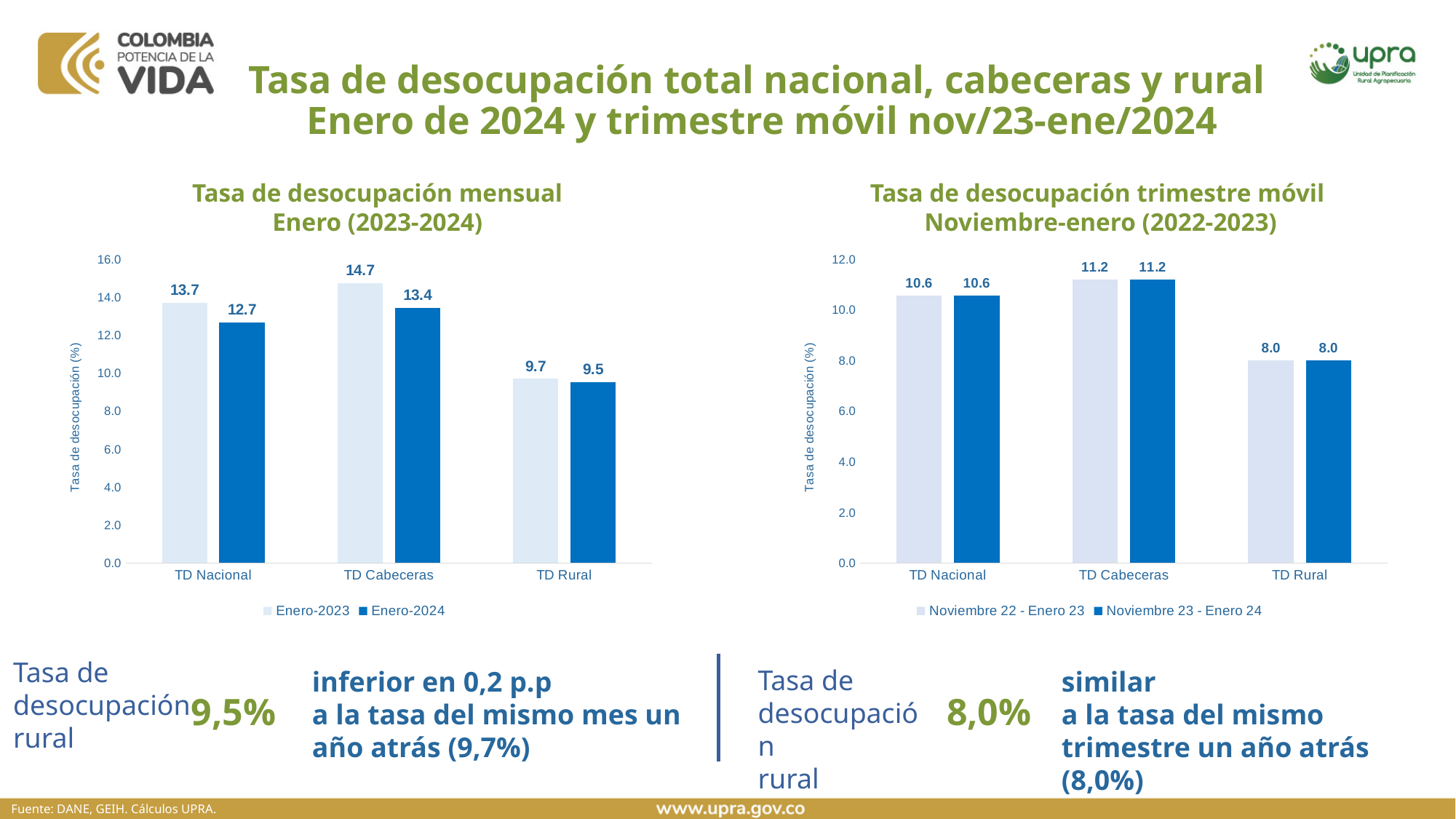
In the right chart (Tasa de desocupación trimestre móvil), which category has the highest value for Noviembre 23 - Enero 24? TD Cabeceras In the right chart (Tasa de desocupación trimestre móvil), what is the value for TD Nacional in Noviembre 23 - Enero 24? 10.6 In the left chart (Tasa de desocupación mensual Enero), which category has the lowest value for Enero-2023? TD Rural In the left chart (Tasa de desocupación mensual Enero), what is the difference between the Enero-2023 and Enero-2024 values for TD Nacional? 1.0 In the left chart (Tasa de desocupación mensual Enero), what is the value for TD Rural in Enero-2023? 9.7 In the left chart (Tasa de desocupación mensual Enero), which is larger for TD Cabeceras: Enero-2023 or Enero-2024? Enero-2023 In the right chart (Tasa de desocupación trimestre móvil), what is the difference between TD Cabeceras and TD Rural for Noviembre 23 - Enero 24? 3.2 In the left chart (Tasa de desocupación mensual Enero), what is the value for TD Cabeceras in Enero-2024? 13.4 In the right chart (Tasa de desocupación trimestre móvil), what is the value for TD Rural in Noviembre 22 - Enero 23? 8.0 What kind of chart is the left chart (Tasa de desocupación mensual Enero)? Bar chart In the left chart (Tasa de desocupación mensual Enero), which category has the highest value for Enero-2024? TD Cabeceras How many series does the legend of the right chart (Tasa de desocupación trimestre móvil) list? 2